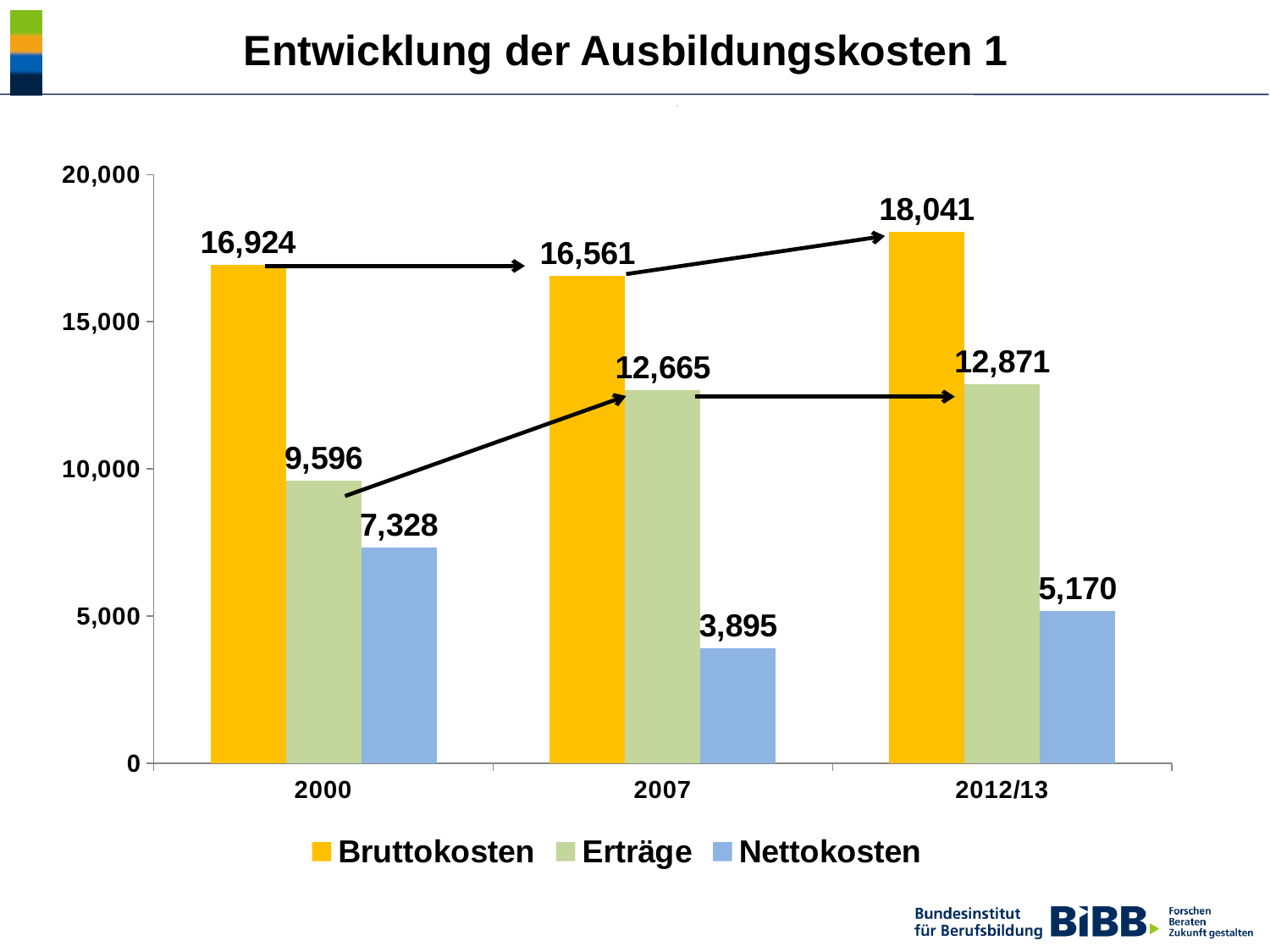
How many series does the legend list? 3 In which year is Bruttokosten highest? 2012/13 What is the value of Nettokosten for 2007? 3,895 What is the difference between Bruttokosten and Erträge in 2007? 3,896 In which year is Nettokosten lowest? 2007 Is the value of Erträge for 2000 greater or less than 10,000? less Do the Erträge values rise or fall from 2000 to 2012/13? rise What is the value of Erträge for 2012/13? 12,871 How many years are shown on the x axis? 3 What kind of chart is shown on the slide? bar chart What is the value of Bruttokosten for 2000? 16,924 Which is larger, Erträge in 2000 or Nettokosten in 2012/13? Erträge in 2000